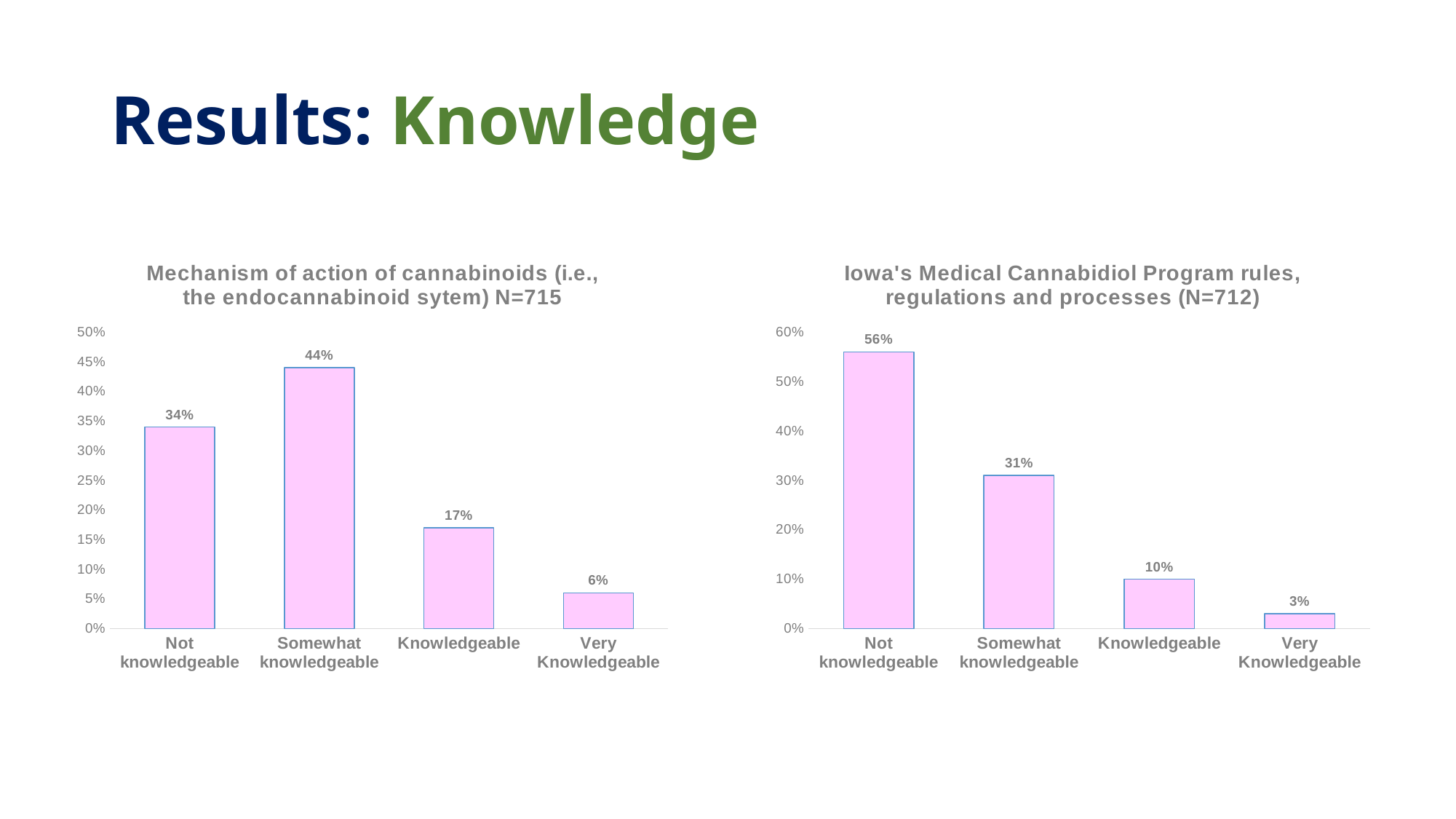
In the right chart (Iowa's Medical Cannabidiol Program rules), what is the value for Not knowledgeable? 56% In the right chart (Iowa's Medical Cannabidiol Program rules), which category has the lowest value? Very Knowledgeable In the left chart (Mechanism of action of cannabinoids), which category has the highest value? Somewhat knowledgeable In the left chart (Mechanism of action of cannabinoids), is the value for Knowledgeable greater or less than 20%? less How many categories are shown in the right chart (Iowa's Medical Cannabidiol Program rules)? 4 What kind of chart is the left chart (Mechanism of action of cannabinoids)? Bar chart In the right chart (Iowa's Medical Cannabidiol Program rules), which is larger: Knowledgeable or Very Knowledgeable? Knowledgeable In the left chart (Mechanism of action of cannabinoids), what is the difference between Not knowledgeable and Very Knowledgeable? 28% In the right chart (Iowa's Medical Cannabidiol Program rules), do the values rise or fall from left to right along the x axis? Fall In the right chart (Iowa's Medical Cannabidiol Program rules), what is the difference between Not knowledgeable and Somewhat knowledgeable? 25% In the left chart (Mechanism of action of cannabinoids), what is the value for Somewhat knowledgeable? 44% What is the sample size (N) stated in the title of the left chart? 715